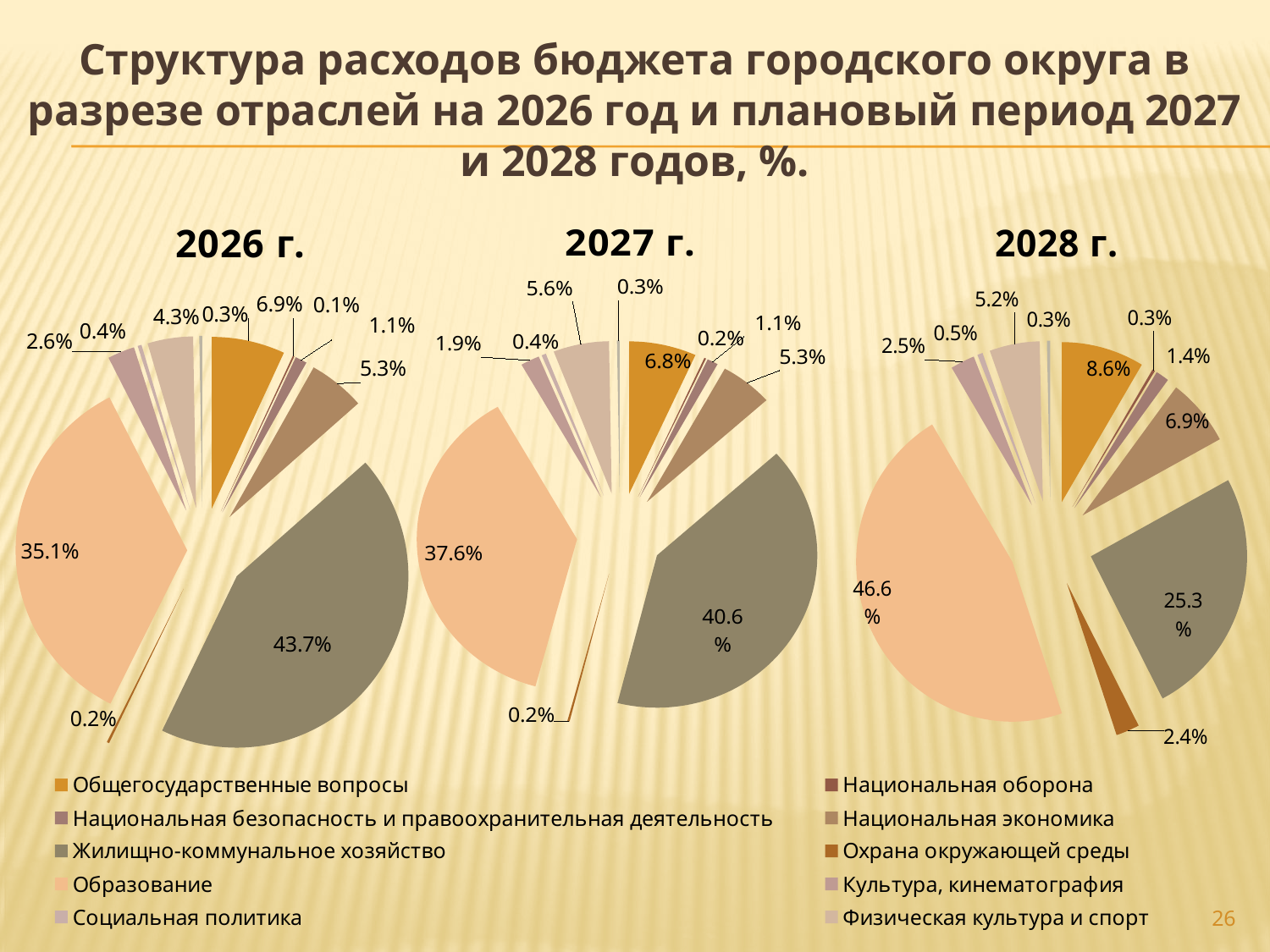
How many categories does the legend list? 10 How many pie charts are shown on the slide? 3 What kind of chart is used on this slide? Pie chart In the 2026 г. pie chart, what is the difference between the shares of Жилищно-коммунальное хозяйство and Образование? 8.6 percentage points In the 2026 г. pie chart, which category has the largest share? Жилищно-коммунальное хозяйство In the 2028 г. pie chart, what is the share of Жилищно-коммунальное хозяйство? 25.3% In the 2028 г. pie chart, what is the share of Охрана окружающей среды? 2.4% In the 2027 г. pie chart, what is the share of Образование? 37.6% In the 2027 г. pie chart, which is larger: Жилищно-коммунальное хозяйство or Образование? Жилищно-коммунальное хозяйство Does the share of Образование rise or fall from the 2026 г. chart to the 2028 г. chart? Rises In the 2028 г. pie chart, what is the share of Общегосударственные вопросы? 8.6% In the 2028 г. pie chart, which category has the largest share? Образование